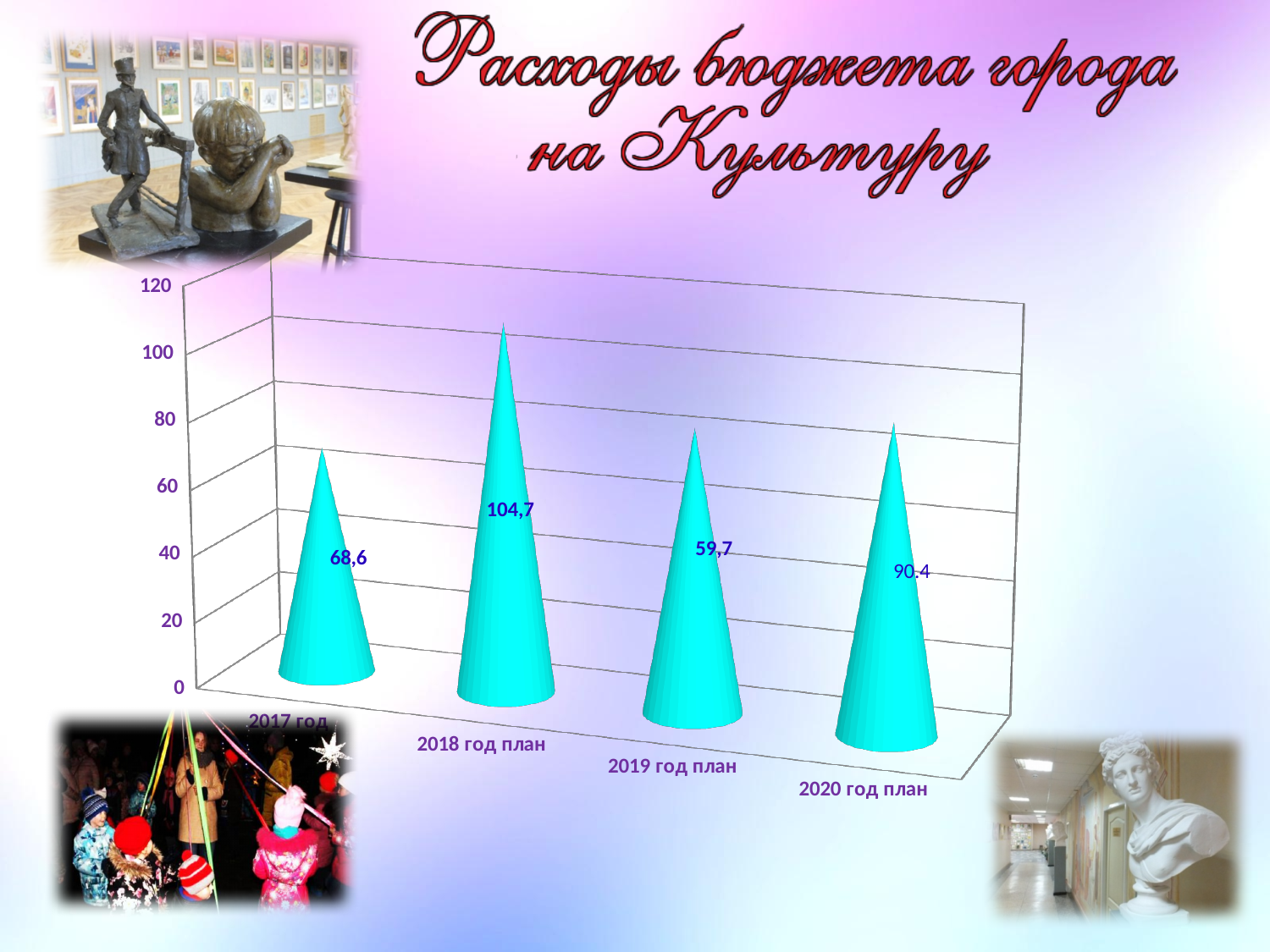
What is the difference between the values for 2018 год план and 2017 год? 36,1 Is the value for 2020 год план greater or less than 80? greater What is the title of the slide? Расходы бюджета города на Культуру What is the value for 2017 год? 68,6 What is the difference between the values for 2018 год план and 2019 год план? 45 What kind of chart is shown on the slide? bar chart How many categories are shown on the chart? 4 What is the value for 2019 год план? 59,7 What is the value for 2018 год план? 104,7 Which category has the highest value? 2018 год план